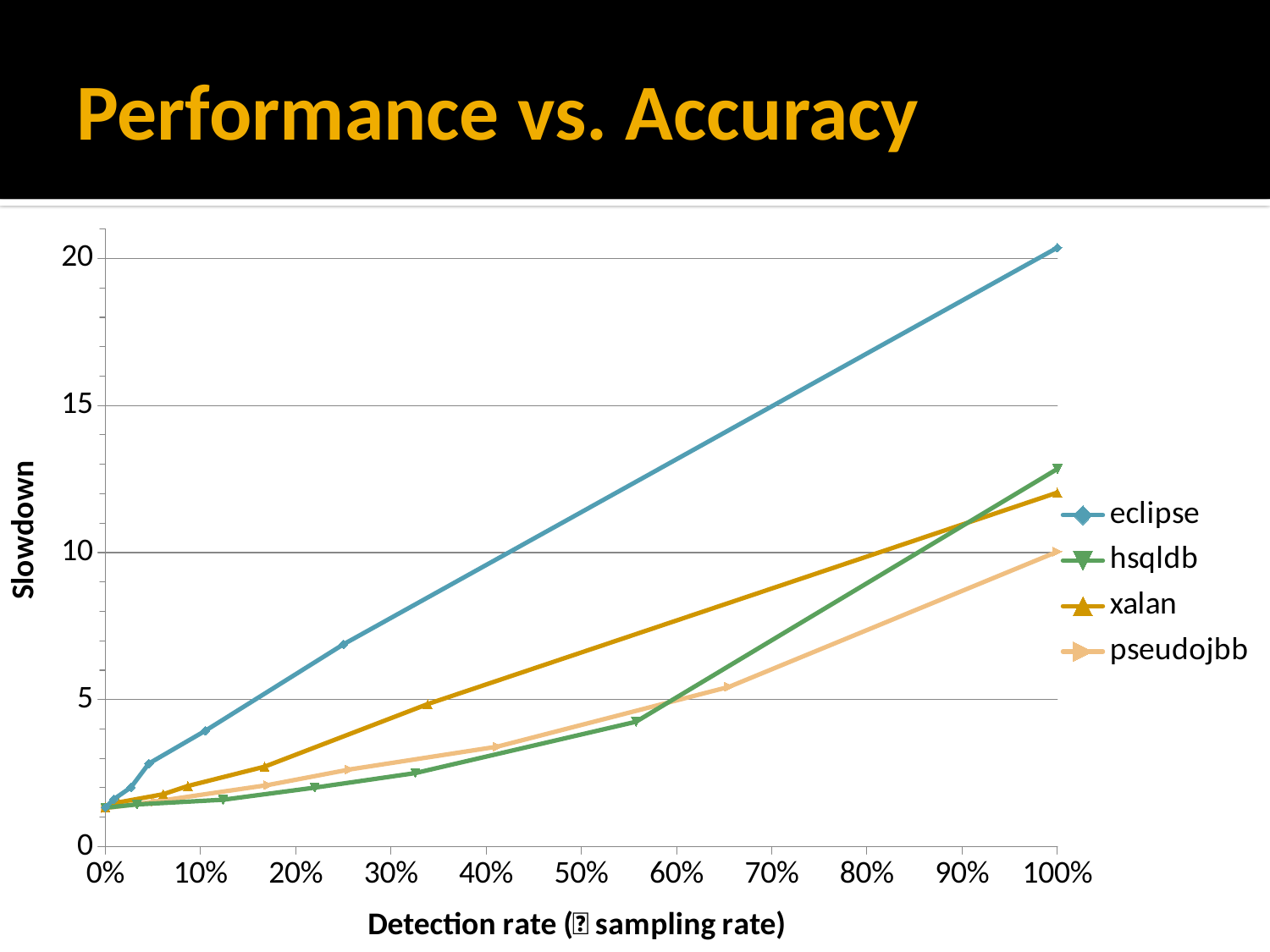
Does the slowdown for eclipse rise or fall as the detection rate increases? rise Which series has the highest slowdown at a 100% detection rate? eclipse Is the slowdown for hsqldb at a 100% detection rate greater or less than 10? greater Is the slowdown for eclipse at a 100% detection rate greater or less than 15? greater What is the label of the vertical axis? Slowdown Is the slowdown for eclipse at a 25% detection rate greater or less than 5? greater At a 100% detection rate, which series has the larger slowdown, xalan or pseudojbb? xalan Which series are listed in the legend? eclipse, hsqldb, xalan, pseudojbb What kind of chart is shown on the slide? line chart At a 100% detection rate, which series has the larger slowdown, eclipse or hsqldb? eclipse Which series has the lowest slowdown at a 100% detection rate? pseudojbb How many series does the legend list? 4